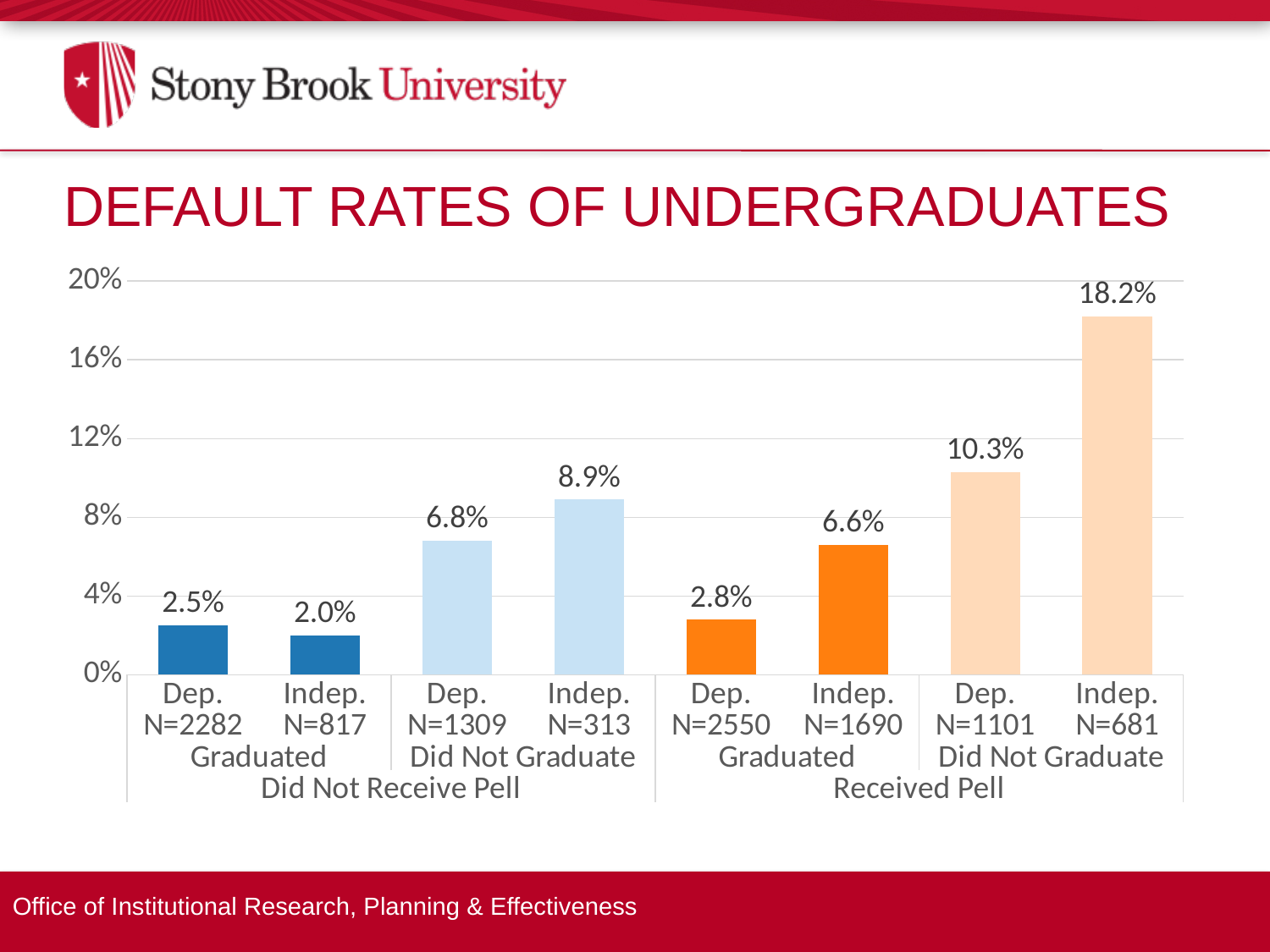
What is the difference in default rate between independent and dependent students who did not graduate and did not receive Pell? 2.1% What is the default rate for independent students who did not graduate and received Pell? 18.2% What is the title of the chart? DEFAULT RATES OF UNDERGRADUATES Which group has the lowest default rate? Indep. Graduated, Did Not Receive Pell Is the default rate for independent students who did not graduate and received Pell greater or less than 16%? greater What is the difference in default rate between independent and dependent students who did not graduate and received Pell? 7.9% Which group has the highest default rate? Indep. Did Not Graduate, Received Pell What type of chart is shown on the slide? Bar chart What is the default rate for dependent students who graduated and did not receive Pell? 2.5% What is the default rate for dependent students who did not graduate and received Pell? 10.3% Which has a higher default rate: dependent graduates who received Pell or dependent graduates who did not receive Pell? Dependent graduates who received Pell How many bars are shown in the chart? 8